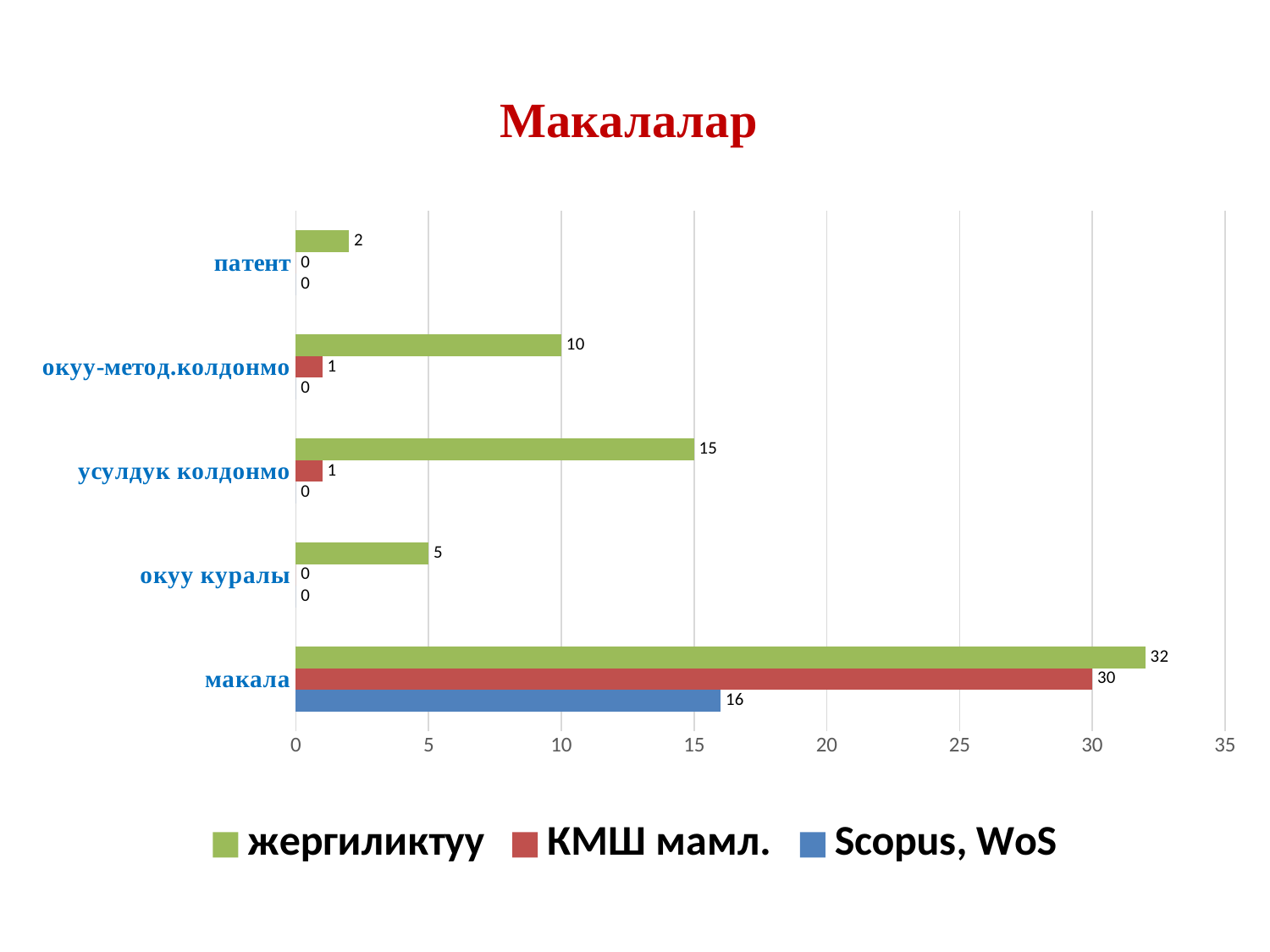
What is the value for жергиликтуу in the усулдук колдонмо category? 15 Which is larger in the макала category: КМШ мамл. or Scopus, WoS? КМШ мамл. What is the difference between the жергиликтуу and КМШ мамл. values in the макала category? 2 Which category has the highest value for жергиликтуу? макала Which category has the lowest value for жергиликтуу? патент What is the value for КМШ мамл. in the окуу-метод.колдонмо category? 1 How many series does the legend list? 3 What is the value for Scopus, WoS in the макала category? 16 What is the value for жергиликтуу in the макала category? 32 What is the title of the slide? Макалалар How many categories are shown on the chart? 5 What kind of chart is shown on the slide? bar chart